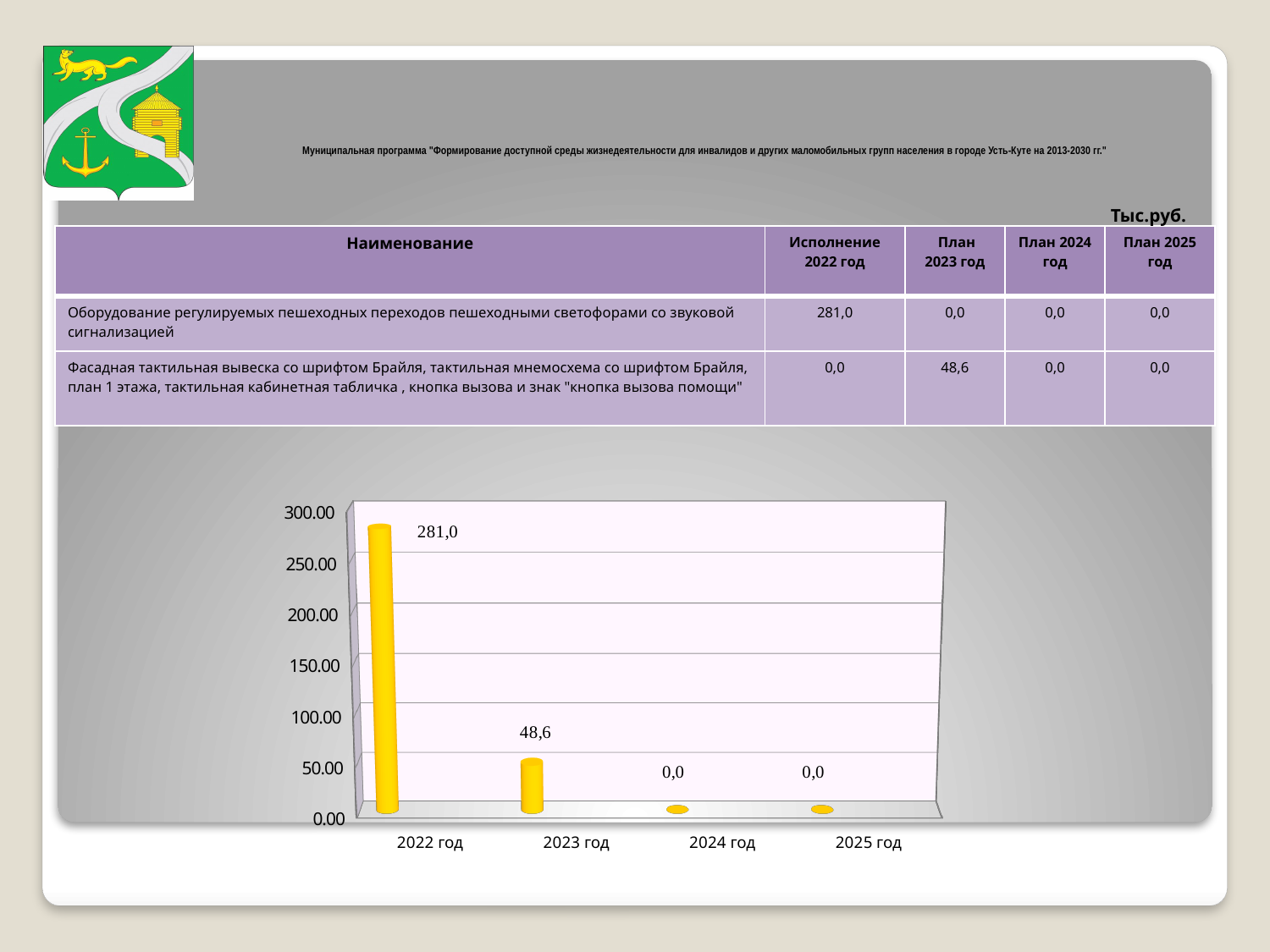
What kind of chart is shown on the slide? bar chart What is the value shown for 2024 год in the chart? 0,0 Is the value for 2022 год greater or less than 250.00? greater Which is larger, the value for 2022 год or the value for 2023 год? 2022 год What is the value shown for 2025 год in the chart? 0,0 Do the values rise or fall from 2022 год to 2024 год? fall How many year categories are shown on the x axis of the chart? 4 Which year has the highest value in the chart? 2022 год What is the value shown for 2023 год in the chart? 48,6 What is the value shown for 2022 год in the chart? 281,0 What is the difference between the values for 2022 год and 2023 год? 232,4 Is the value for 2023 год greater or less than 100.00? less